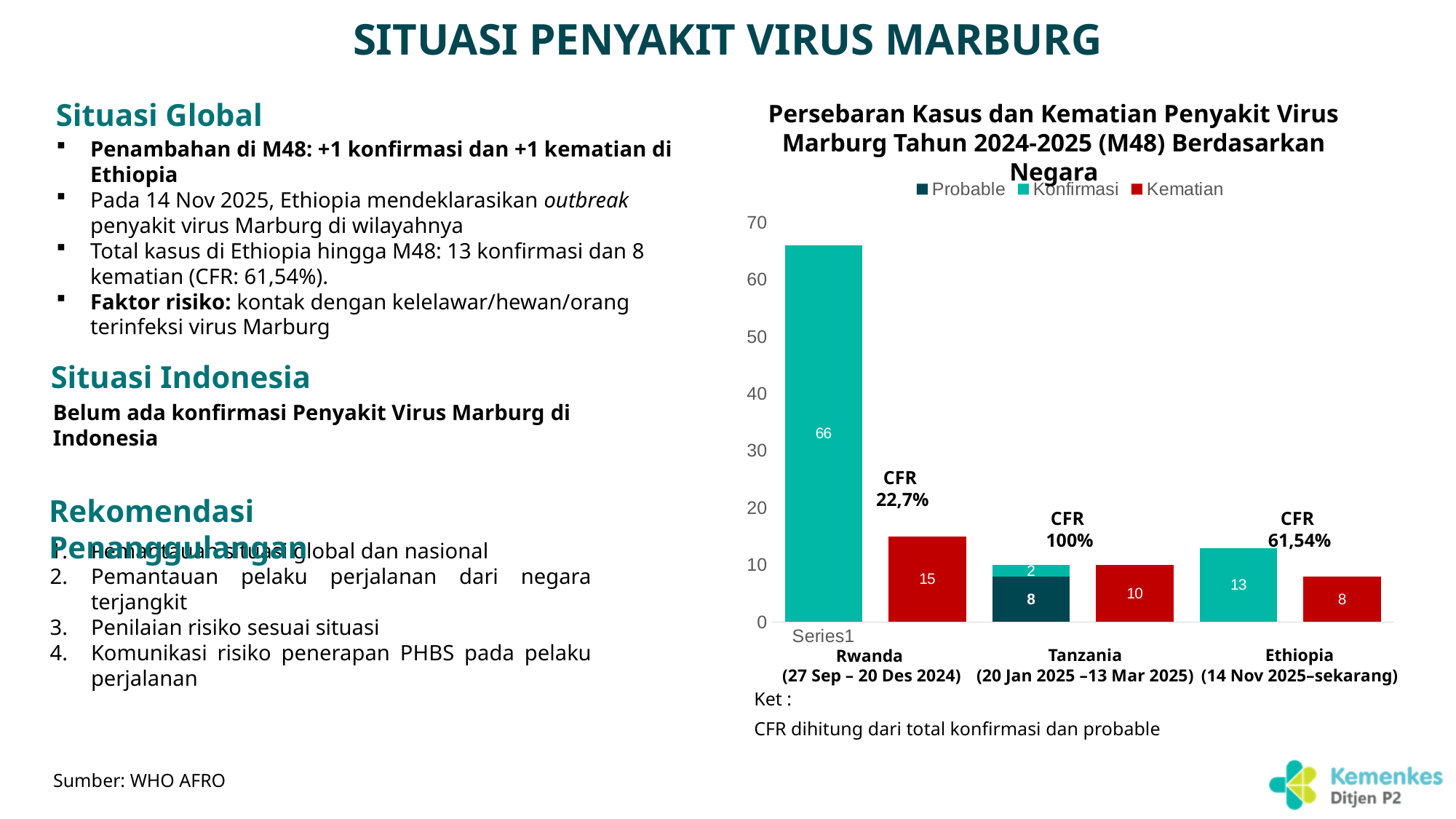
Which country has the lowest Kematian value in the chart? Ethiopia What type of chart is shown on the slide? Bar chart What CFR is shown for Tanzania in the chart? 100% How many series does the chart legend list? 3 Which country has the highest Konfirmasi value in the chart? Rwanda What is the Kematian value for Ethiopia in the chart? 8 What is the Probable value for Tanzania in the chart? 8 What is the difference between the Konfirmasi values for Rwanda and Ethiopia? 53 What is the total of the stacked bar (Probable plus Konfirmasi) for Tanzania? 10 Which is larger for Tanzania: the Probable value or the Konfirmasi value? Probable What is the Konfirmasi value for Rwanda in the chart? 66 What is the Kematian value for Tanzania in the chart? 10